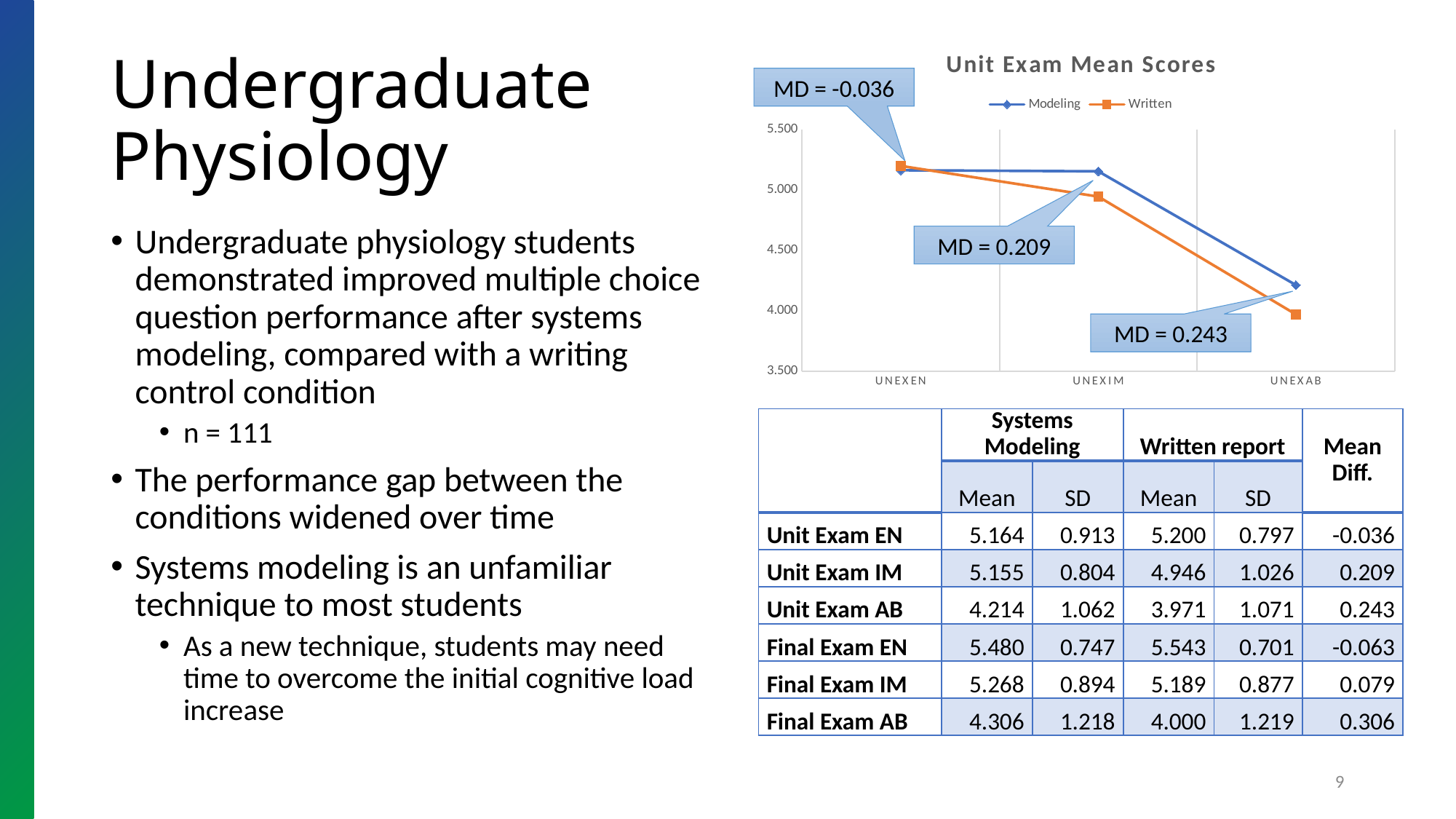
Is the Written value at UNEXEN greater or less than 5.000? greater What is the title of the chart? Unit Exam Mean Scores At which category is the Written series highest? UNEXEN At UNEXAB, which series has the higher value, Modeling or Written? Modeling Which series is drawn in orange on the chart? Written Is the Modeling value at UNEXAB greater or less than 4.500? less Do the Modeling values rise or fall from UNEXEN to UNEXAB? fall What kind of chart is shown on the slide? line chart How many series does the chart legend list? 2 At which category is the Written series lowest? UNEXAB How many categories are shown on the x axis of the chart? 3 What mean difference (MD) is shown in the callout for UNEXAB on the chart? MD = 0.243